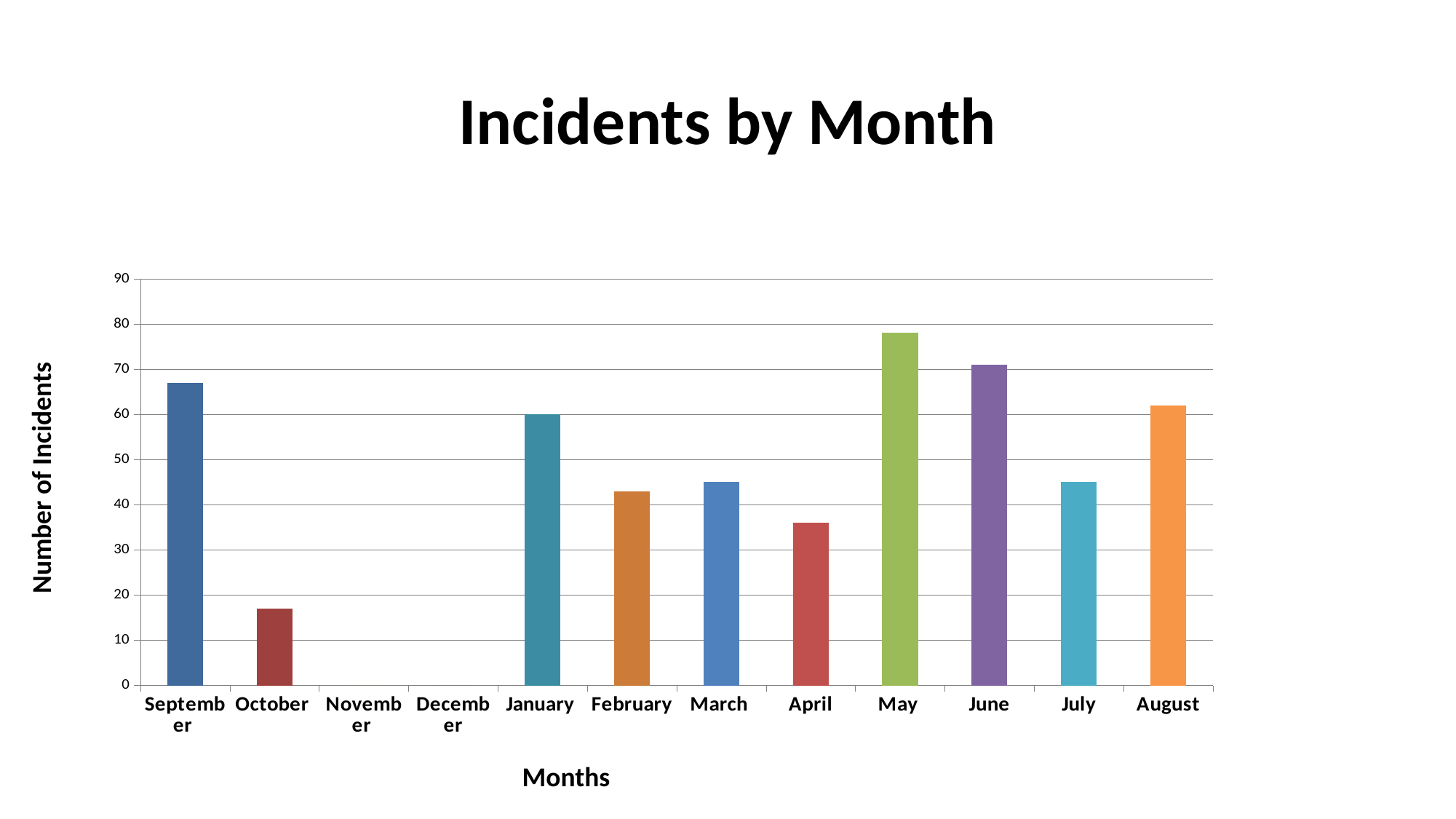
How many months are shown on the x axis of the chart? 12 Which has more incidents, May or June? May What is the title of the chart? Incidents by Month Which has more incidents, February or April? February Is the value for October greater or less than 20? less What kind of chart is shown on the slide? bar chart Is the value for April greater or less than 40? less Is the value for May greater or less than 70? greater What is the label of the vertical axis? Number of Incidents Which month has the highest number of incidents? May What is the number of incidents for January? 60 What is the number of incidents for November? 0